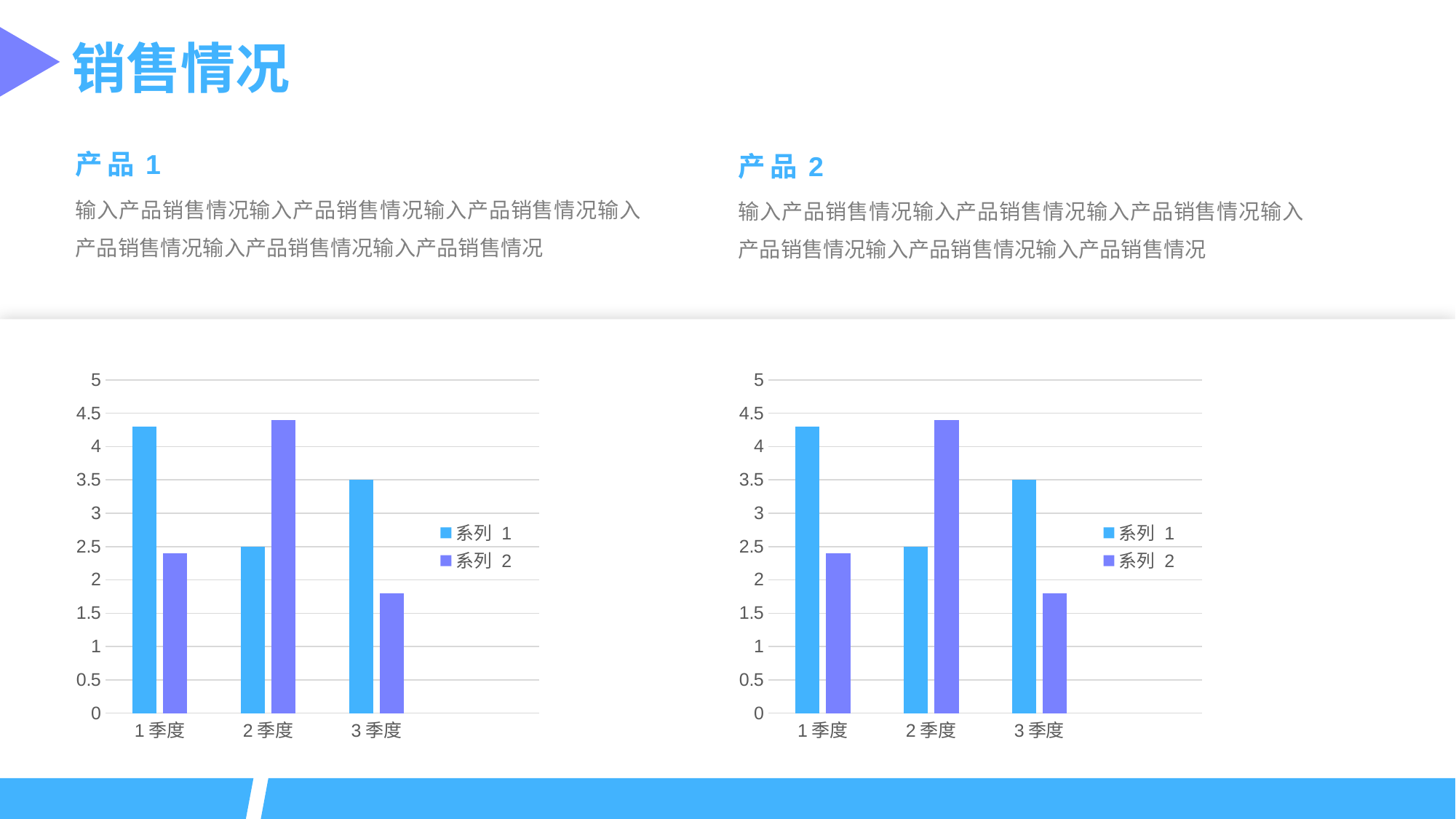
On the left chart, what type of chart is shown? bar chart What are the names of the two series in the legend of the right chart? 系列 1 and 系列 2 On the right chart, which is larger in 3 季度, 系列 1 or 系列 2? 系列 1 On the right chart, is the value for 系列 2 in 2 季度 greater or less than 4? greater On the left chart, which is larger in 2 季度, 系列 1 or 系列 2? 系列 2 On the right chart, which category has the lowest value for 系列 2? 3 季度 On the left chart, is the value for 系列 1 in 1 季度 greater or less than 4? greater On the right chart, is the value for 系列 2 in 3 季度 greater or less than 2? less On the left chart, how many series does the legend list? 2 On the left chart, which category has the highest value for 系列 1? 1 季度 On the left chart, which category has the highest value for 系列 2? 2 季度 On the right chart, how many categories are shown on the x axis? 3